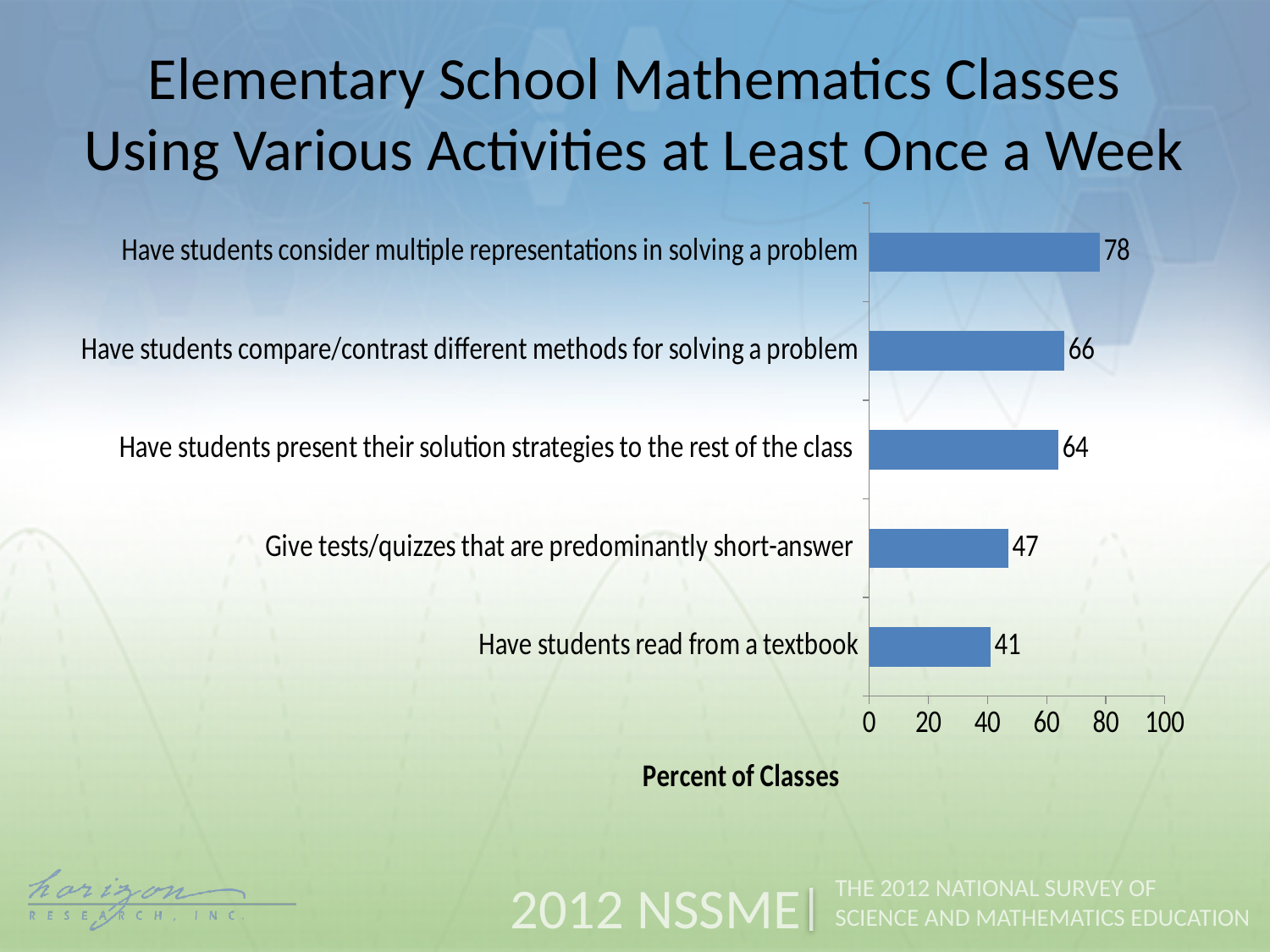
How many activities are shown on the chart? 5 Which is larger: the value for 'Give tests/quizzes that are predominantly short-answer' or the value for 'Have students read from a textbook'? Give tests/quizzes that are predominantly short-answer What is the difference between the highest and lowest values on the chart? 37 Which activity has the highest percent of classes? Have students consider multiple representations in solving a problem Is the value for 'Have students present their solution strategies to the rest of the class' greater or less than 60? greater What is the label of the horizontal axis? Percent of Classes What is the value for 'Have students read from a textbook'? 41 What kind of chart is shown on the slide? bar chart What is the difference between the values for 'Have students compare/contrast different methods for solving a problem' and 'Have students present their solution strategies to the rest of the class'? 2 What percent of classes have students consider multiple representations in solving a problem at least once a week? 78 What percent of classes give tests/quizzes that are predominantly short-answer at least once a week? 47 Which activity has the lowest percent of classes? Have students read from a textbook